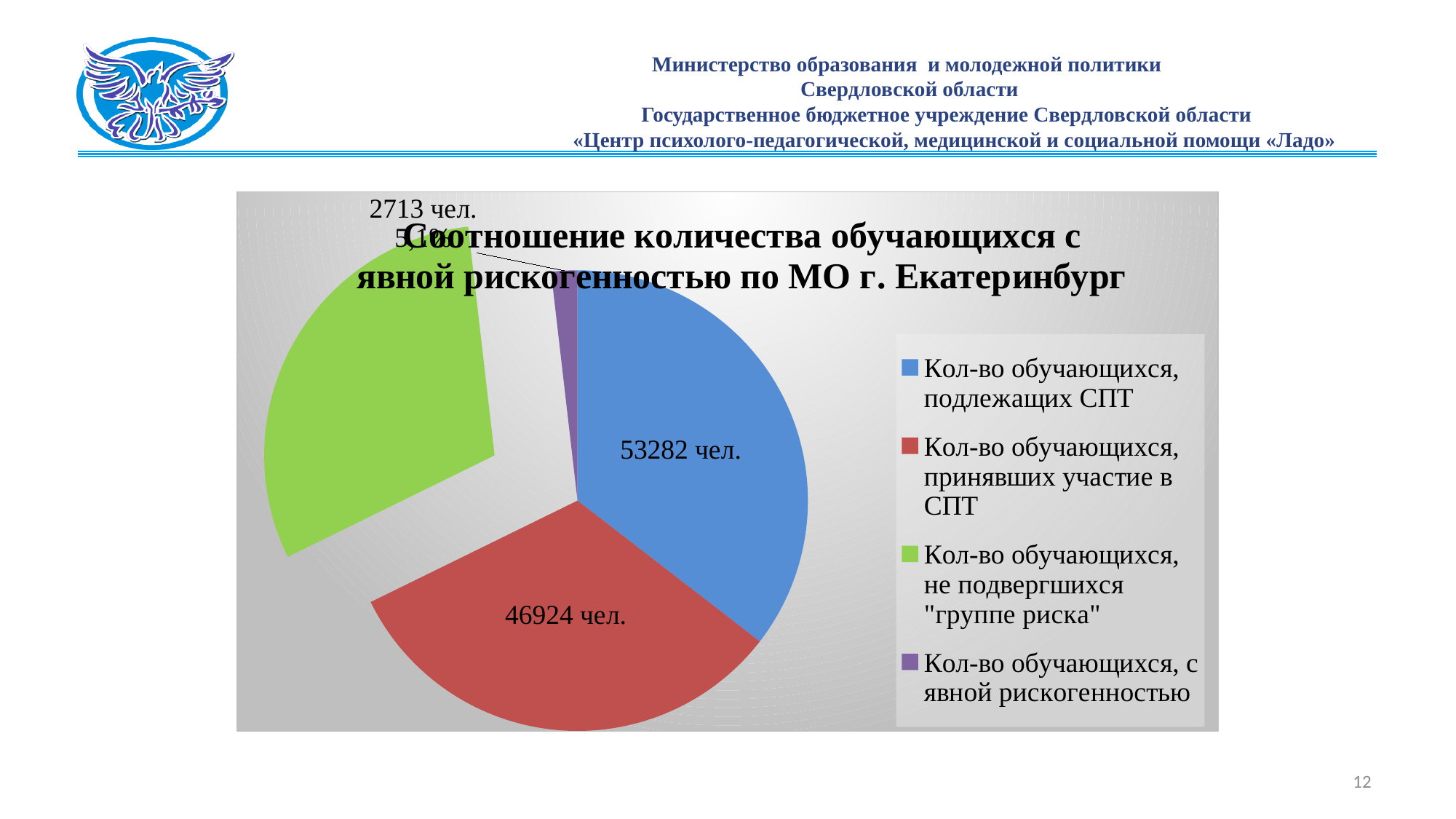
What is the value for "Кол-во обучающихся, с явной рискогенностью"? 2713 чел. How many entries does the legend list? 4 What is the value for "Кол-во обучающихся, принявших участие в СПТ"? 46924 чел. What colour is the slice for "Кол-во обучающихся, с явной рискогенностью"? purple What is the difference between the number of students subject to СПТ and the number who took part in СПТ? 6358 чел. What kind of chart is shown on the slide? pie chart Which is larger: the number of students subject to СПТ or the number who took part in СПТ? Кол-во обучающихся, подлежащих СПТ Which category has the smallest slice of the pie? Кол-во обучающихся, с явной рискогенностью What is the title of the chart? Соотношение количества обучающихся с явной рискогенностью по МО г. Екатеринбург How many slices does the pie chart have? 4 What is the value for "Кол-во обучающихся, подлежащих СПТ"? 53282 чел. Which category has the largest slice of the pie? Кол-во обучающихся, подлежащих СПТ